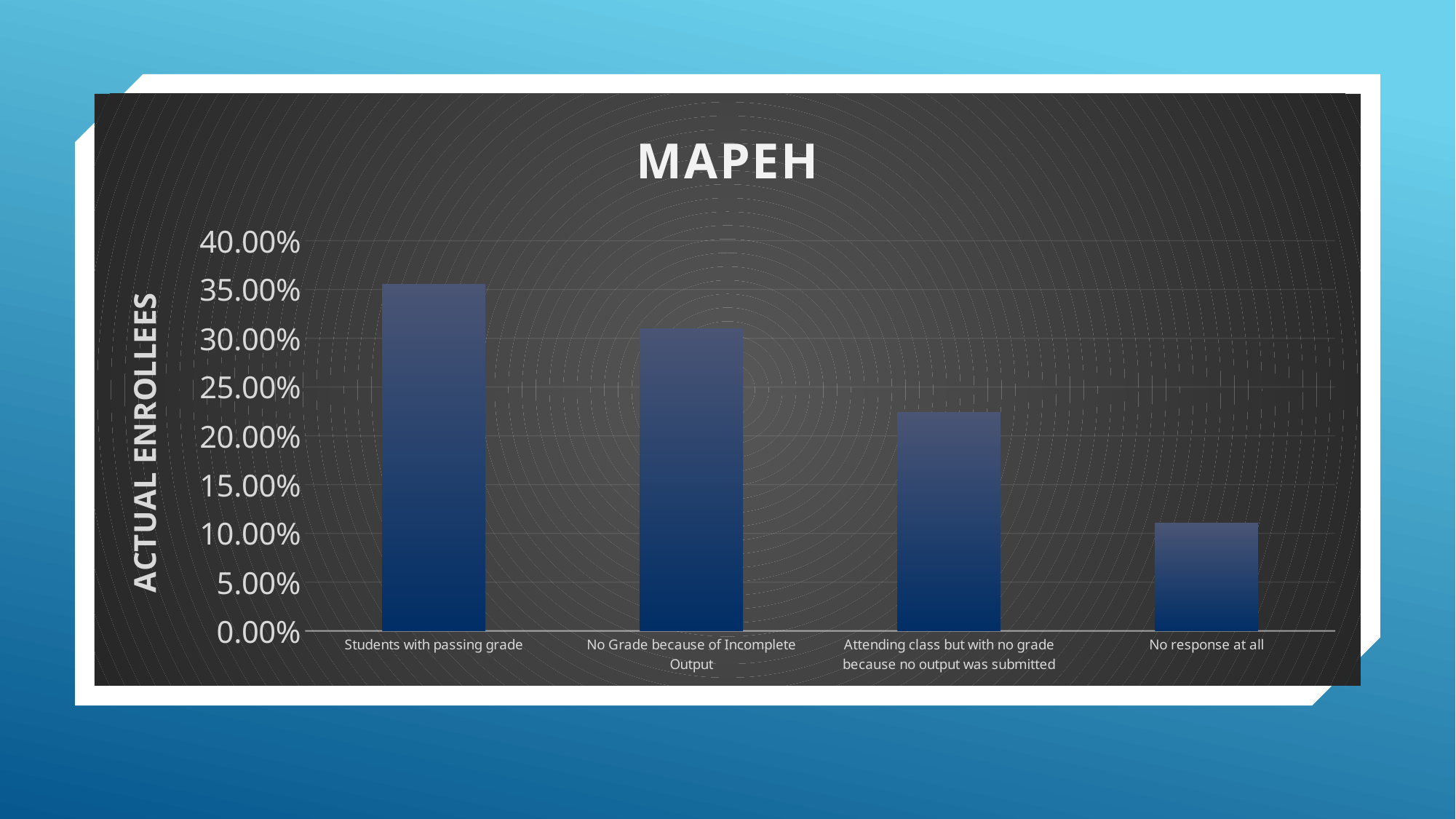
Is the value for Attending class but with no grade because no output was submitted greater or less than 25.00%? less Which is larger: the value for No Grade because of Incomplete Output or the value for No response at all? No Grade because of Incomplete Output What is the title of the chart? MAPEH What is the label of the vertical axis? ACTUAL ENROLLEES Is the value for No response at all greater or less than 15.00%? less Do the values rise or fall from left to right along the x axis? fall How many categories are shown on the x axis? 4 Is the value for No Grade because of Incomplete Output greater or less than 30.00%? greater What kind of chart is shown on the slide? bar chart Which category has the highest value? Students with passing grade Which category has the lowest value? No response at all